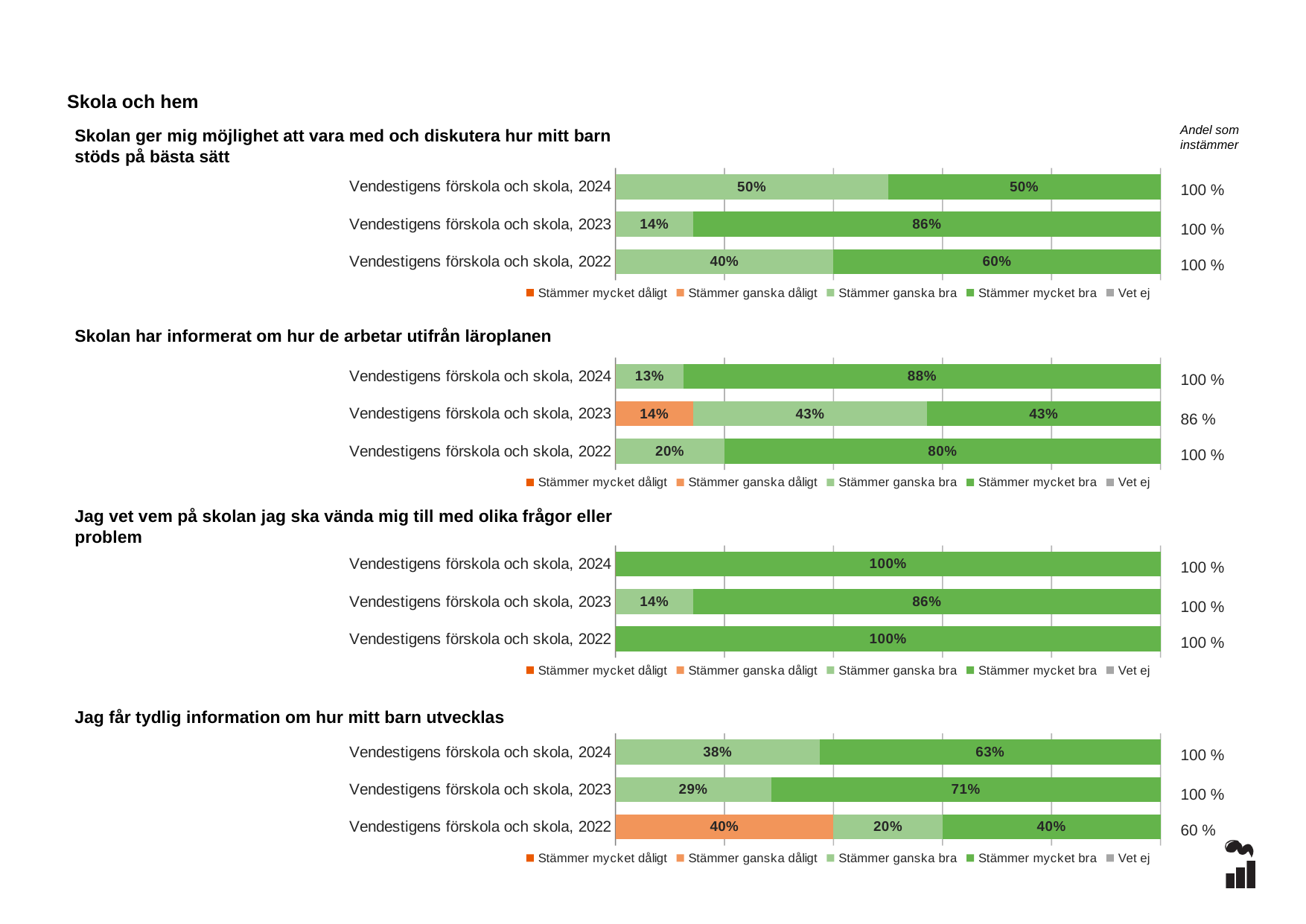
In the chart 'Jag vet vem på skolan jag ska vända mig till med olika frågor eller problem', which year has the lowest value for 'Stämmer mycket bra'? 2023 In the chart 'Skolan har informerat om hur de arbetar utifrån läroplanen', what is the value for 'Stämmer ganska dåligt' for Vendestigens förskola och skola, 2023? 14% In the chart 'Jag får tydlig information om hur mitt barn utvecklas', what is the difference between the 'Stämmer mycket bra' values for 2023 and 2024? 8% What kind of chart is 'Jag får tydlig information om hur mitt barn utvecklas'? Stacked bar chart In the chart 'Skolan ger mig möjlighet att vara med och diskutera hur mitt barn stöds på bästa sätt', what is the value for 'Stämmer mycket bra' for Vendestigens förskola och skola, 2023? 86% In the chart 'Jag vet vem på skolan jag ska vända mig till med olika frågor eller problem', what is the value for 'Stämmer mycket bra' for Vendestigens förskola och skola, 2024? 100% In the chart 'Skolan har informerat om hur de arbetar utifrån läroplanen', which year has the highest value for 'Stämmer mycket bra'? 2024 In the chart 'Skolan ger mig möjlighet att vara med och diskutera hur mitt barn stöds på bästa sätt', what is the value for 'Stämmer ganska bra' for Vendestigens förskola och skola, 2022? 40% In the chart 'Skolan har informerat om hur de arbetar utifrån läroplanen', what is the 'Andel som instämmer' for Vendestigens förskola och skola, 2023? 86 % In the chart 'Jag får tydlig information om hur mitt barn utvecklas', what is the value for 'Stämmer ganska dåligt' for Vendestigens förskola och skola, 2022? 40% How many series does the legend list in the chart 'Skolan har informerat om hur de arbetar utifrån läroplanen'? 5 In the chart 'Jag får tydlig information om hur mitt barn utvecklas', which is larger: the 'Stämmer ganska bra' value for 2024 or for 2023? 2024